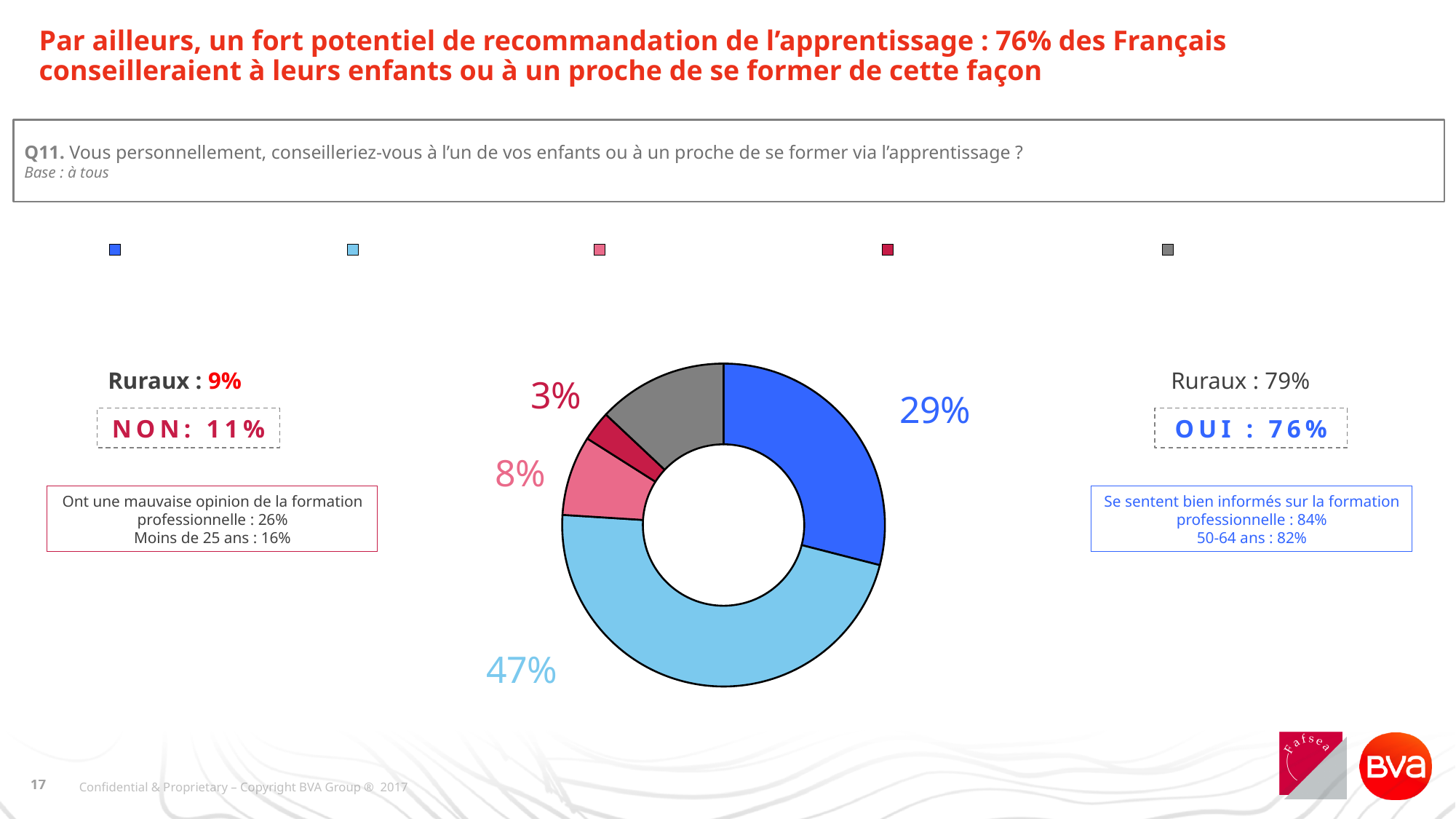
What value is shown for the pink slice of the donut chart? 8% What is the difference between the light blue slice (47%) and the dark blue slice (29%)? 18 percentage points How many entries does the legend above the chart show? 5 What value is shown for the dark blue slice of the donut chart? 29% What kind of chart is shown on the slide? Pie chart (donut) Which is larger, the pink slice or the dark red slice? The pink slice (8%) Which slice of the donut chart is the largest? The light blue slice (47%) What total percentage is shown for 'OUI' on the slide? 76% What value is shown for the dark red slice of the donut chart? 3% How many slices does the donut chart have? 5 Which slice of the donut chart is the smallest? The dark red slice (3%) What value is shown for the light blue slice of the donut chart? 47%